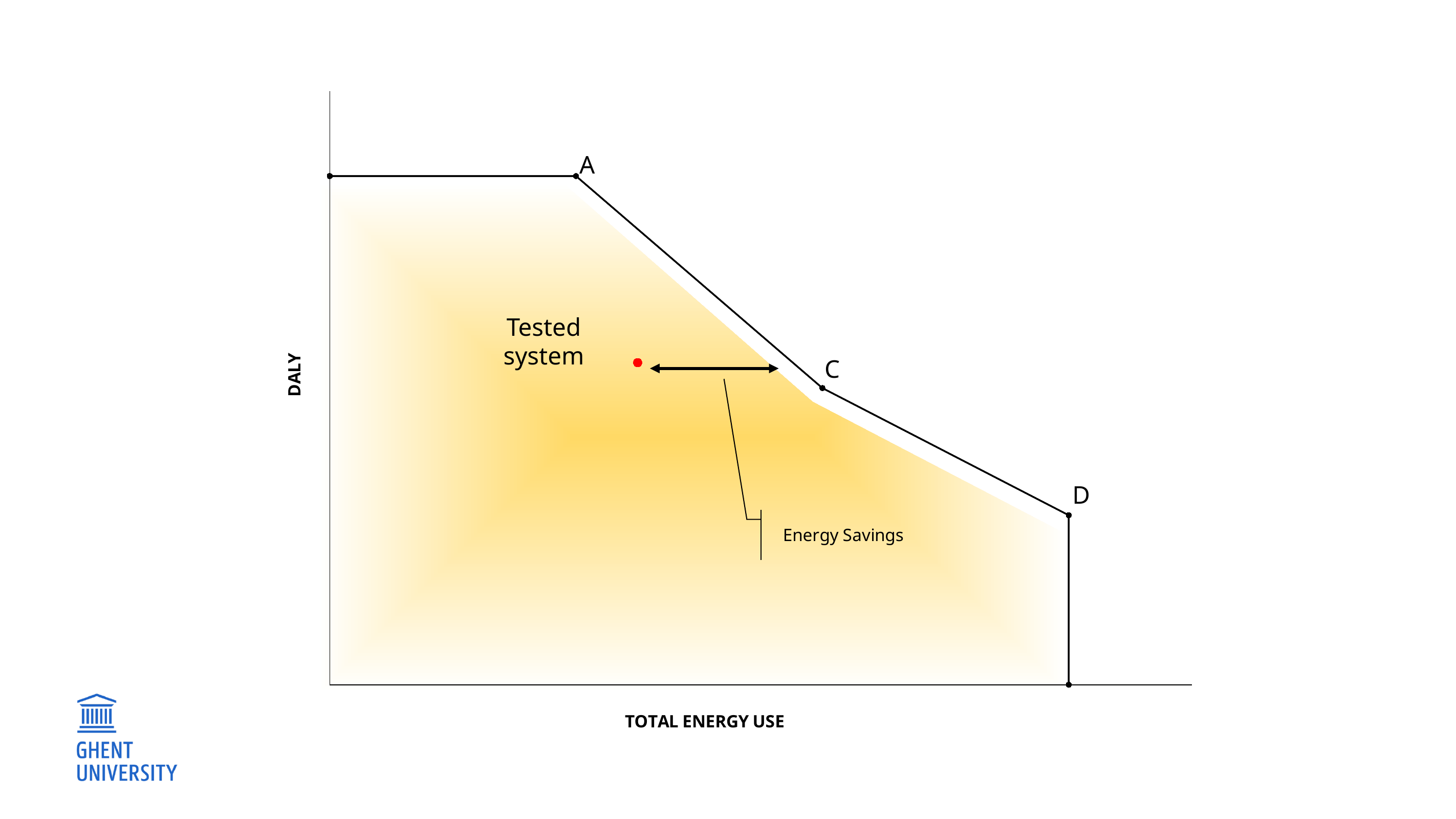
Which has the higher total energy use, point A or point C? C What kind of chart is shown on the slide? Line chart Which lettered point on the frontier has the lowest DALY value? D Which has the lower total energy use, the tested system or point C? Tested system How many lettered points are labeled on the frontier line? 3 Do the DALY values rise or fall as total energy use increases along the frontier line? Fall What is the label of the y axis? DALY Which has the higher DALY value, point A or point D? A Which lettered point on the frontier has the highest DALY value? A What is the label of the x axis? TOTAL ENERGY USE Which lettered point has the highest total energy use? D